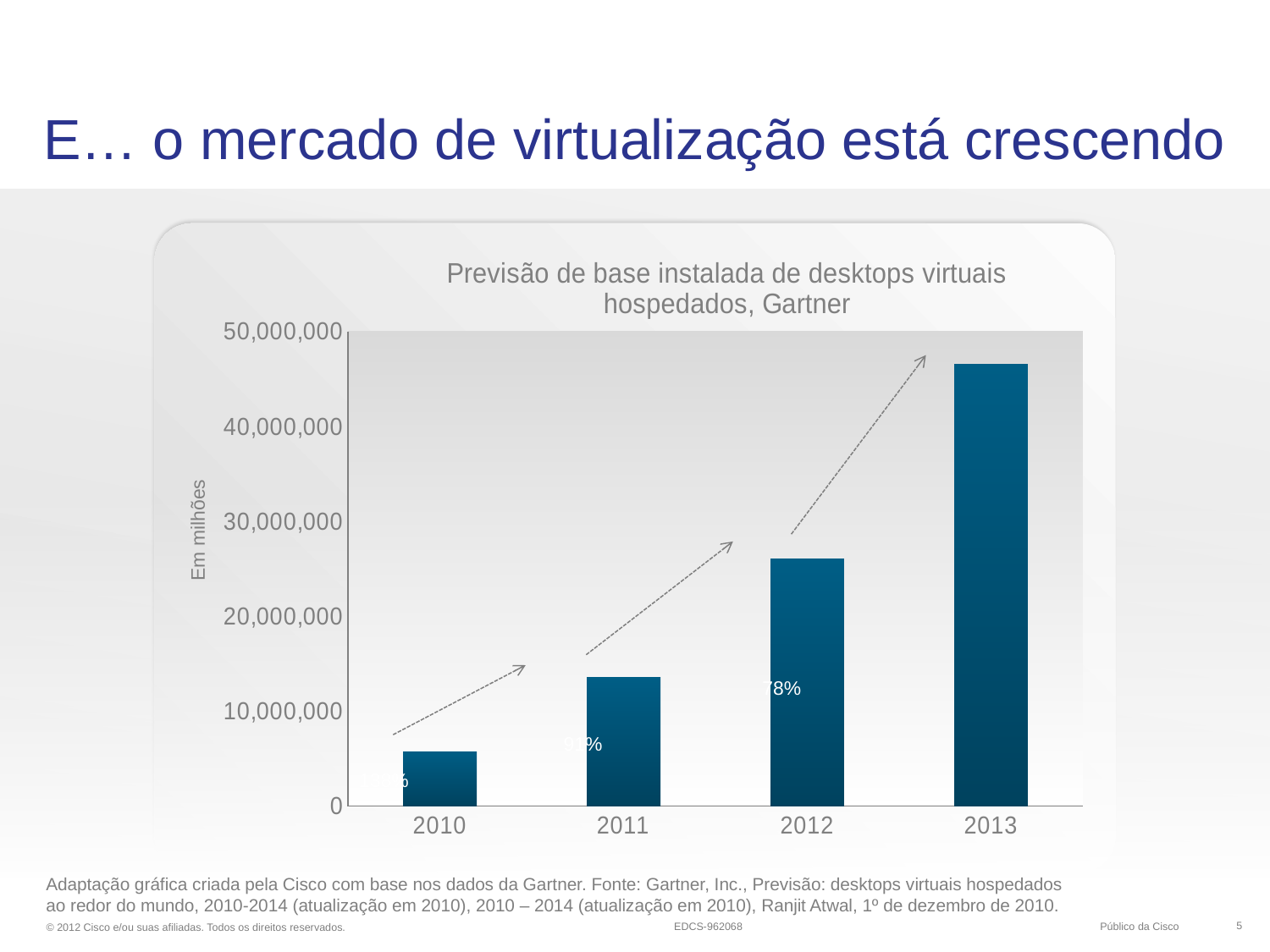
How many years are shown on the x axis of the chart? 4 Do the values rise or fall from 2010 to 2013? Rise Is the value for 2011 greater or less than 20,000,000? less What is the title of the chart? Previsão de base instalada de desktops virtuais hospedados, Gartner Is the value for 2012 greater or less than 20,000,000? greater Which is larger, the value for 2012 or the value for 2011? 2012 Which year has the lowest bar in the chart? 2010 Is the value for 2013 greater or less than 40,000,000? greater What kind of chart is shown on the slide? Bar chart What is the label on the y axis of the chart? Em milhões Which year has the highest bar in the chart? 2013